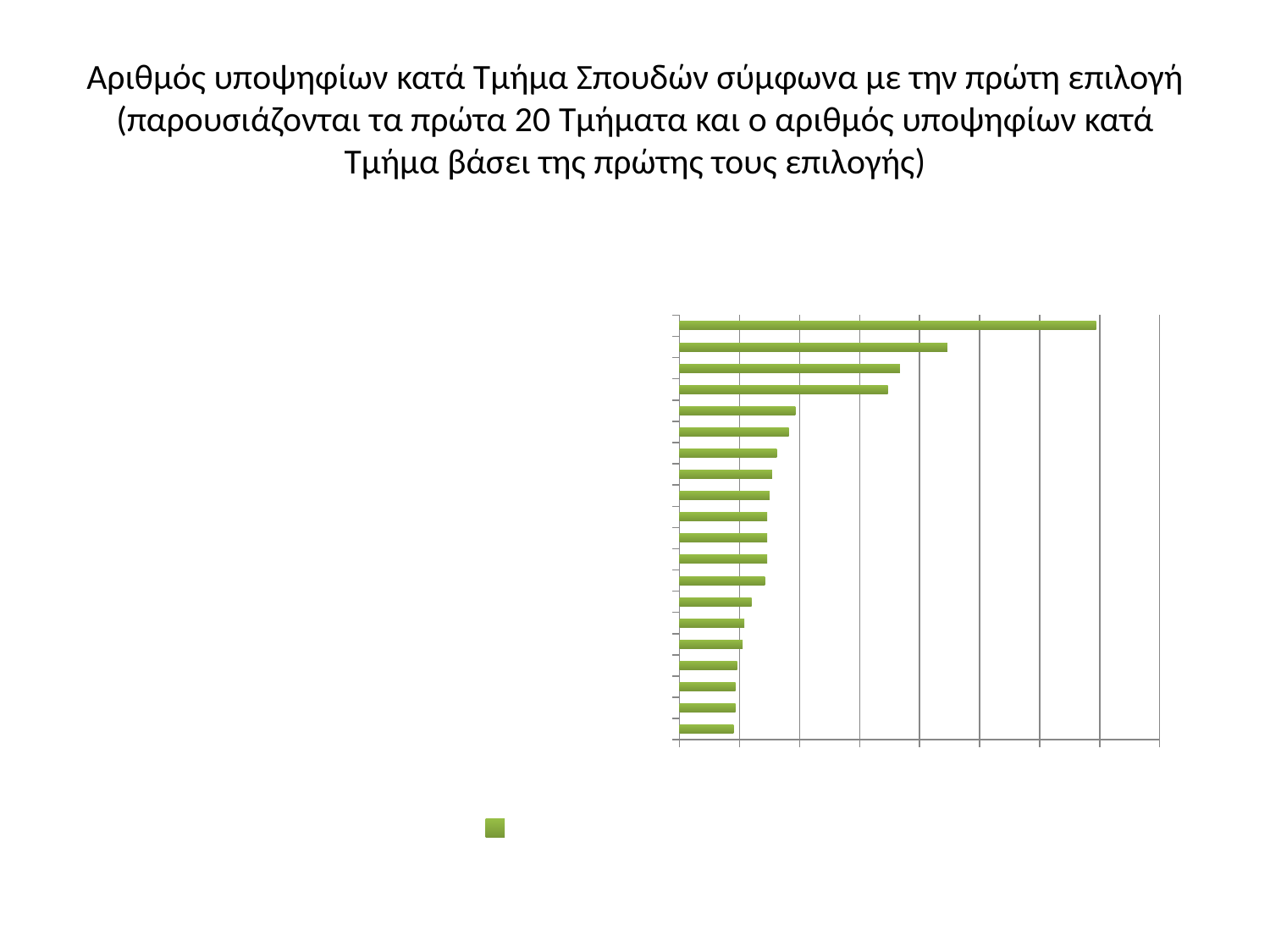
What colour are the bars in the chart? green What is the title of the slide's chart? Αριθμός υποψηφίων κατά Τμήμα Σπουδών σύμφωνα με την πρώτη επιλογή (παρουσιάζονται τα πρώτα 20 Τμήματα και ο αριθμός υποψηφίων κατά Τμήμα βάσει της πρώτης τους επιλογής) How many series does the legend list? 1 Which bar is longer, the top bar or the bottom bar? the top bar Do the bars get longer or shorter going from the top of the chart to the bottom? shorter How many bars does the chart contain? 20 What kind of chart is shown on the slide? bar chart Are the bars in the chart horizontal or vertical? horizontal